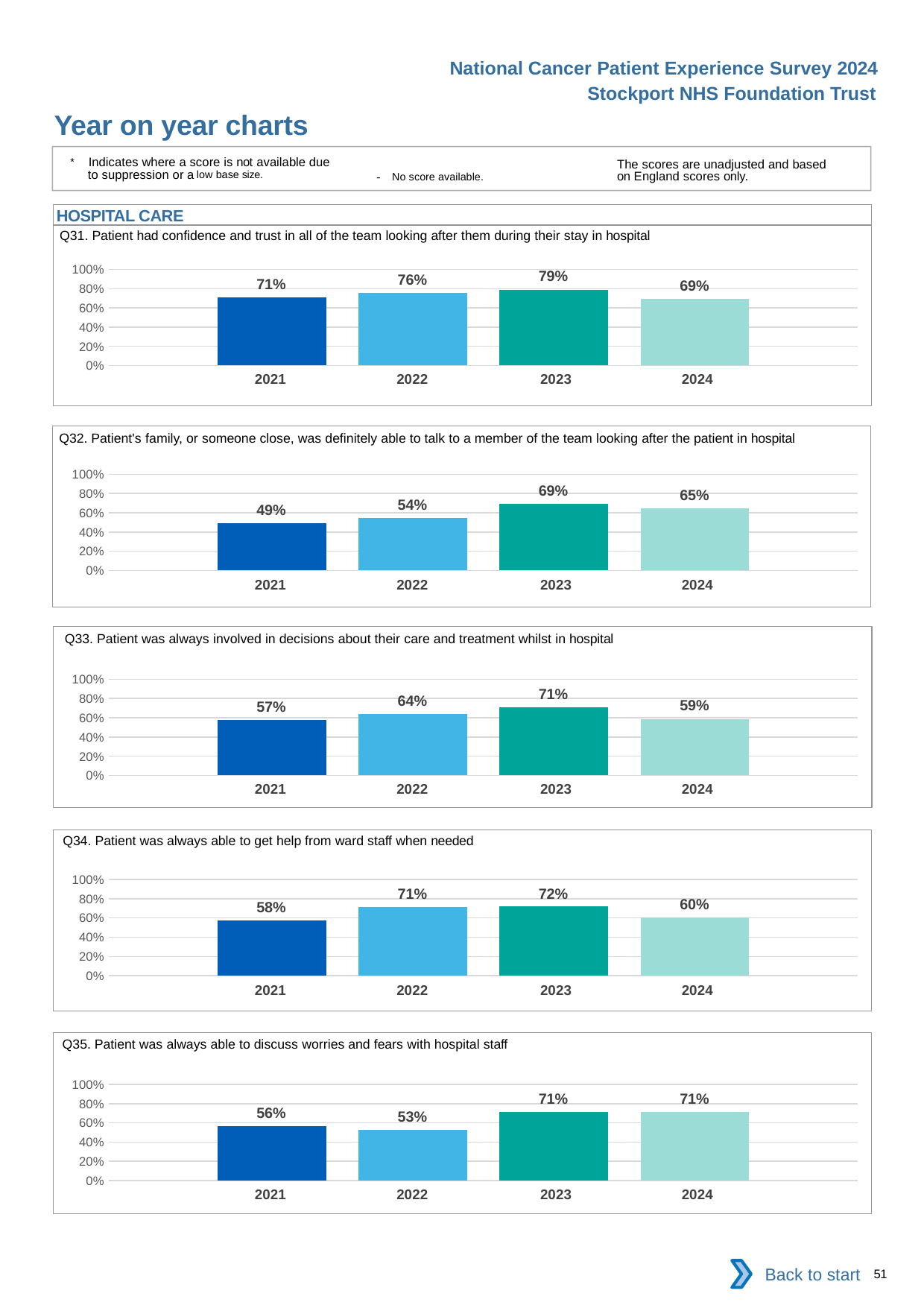
In the Q32 chart, what is the difference between the 2021 and 2023 values? 20 percentage points In the Q31 chart, what is the value for 2023? 79% What kind of chart is the Q34 chart? Bar chart In the Q31 chart, which year has the highest value? 2023 How many charts are shown on the slide? 5 In the Q33 chart, what is the difference between the 2023 and 2024 values? 12 percentage points In the Q33 chart, what is the value for 2021? 57% In the Q34 chart, which is larger, the value for 2022 or the value for 2024? 2022 In the Q35 chart, is the value for 2021 greater or less than 60%? less In the Q32 chart, which year has the lowest value? 2021 In the Q35 chart, what is the value for 2022? 53% How many years are shown in the Q32 chart? 4